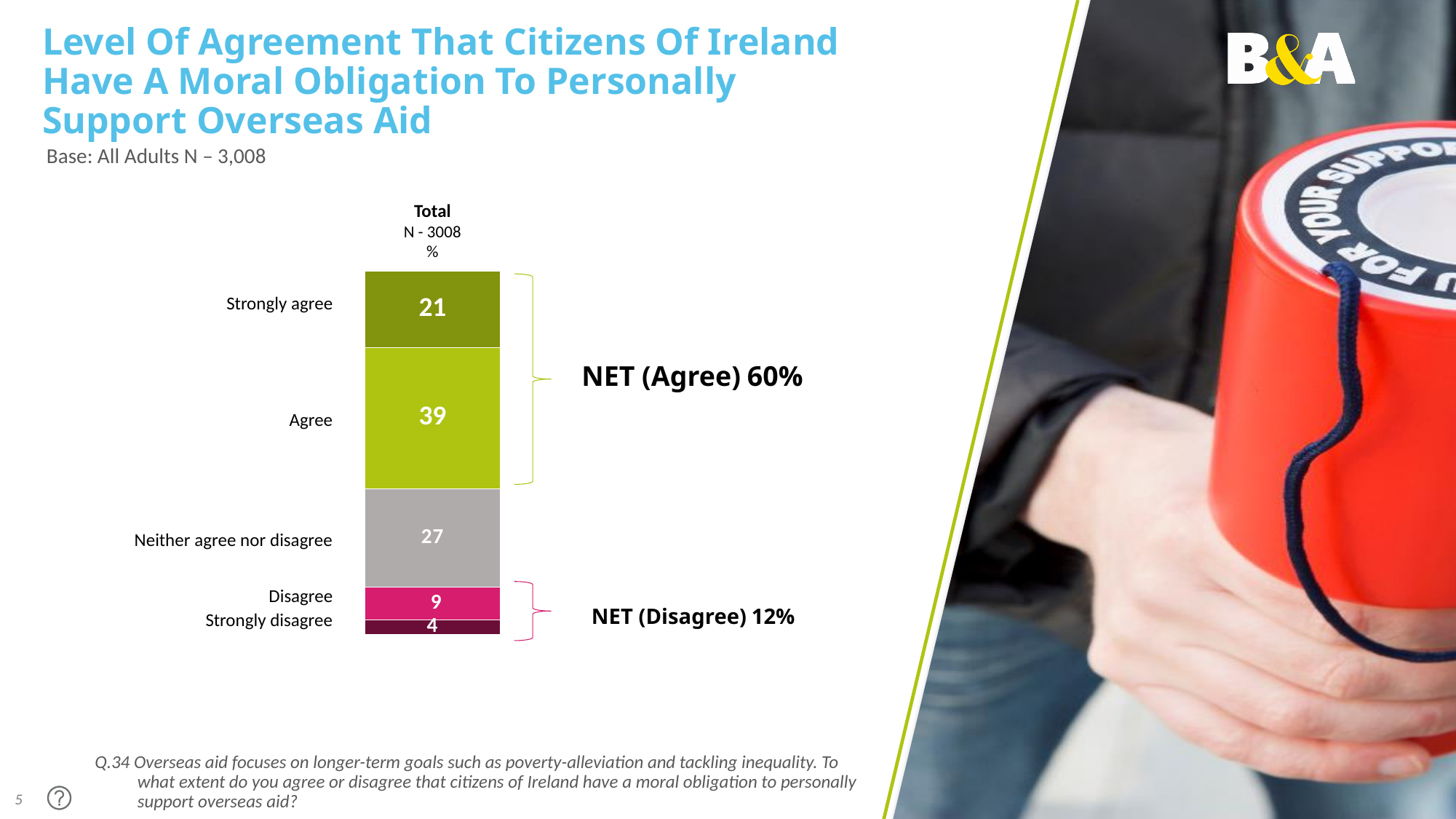
What percentage of respondents neither agree nor disagree? 27 Which response category has the highest percentage? Agree What type of chart is used on the slide? Stacked bar chart Which response category has the lowest percentage? Strongly disagree What is the NET (Agree) percentage shown on the slide? 60% What percentage of respondents chose 'Agree'? 39 What percentage of respondents strongly agree that citizens of Ireland have a moral obligation to personally support overseas aid? 21 How many response categories are shown in the stacked bar? 5 What percentage of respondents strongly disagree? 4 What is the difference in percentage points between 'Agree' and 'Strongly agree'? 18 Which is larger, the percentage for 'Neither agree nor disagree' or for 'Strongly agree'? Neither agree nor disagree What is the NET (Disagree) percentage shown on the slide? 12%